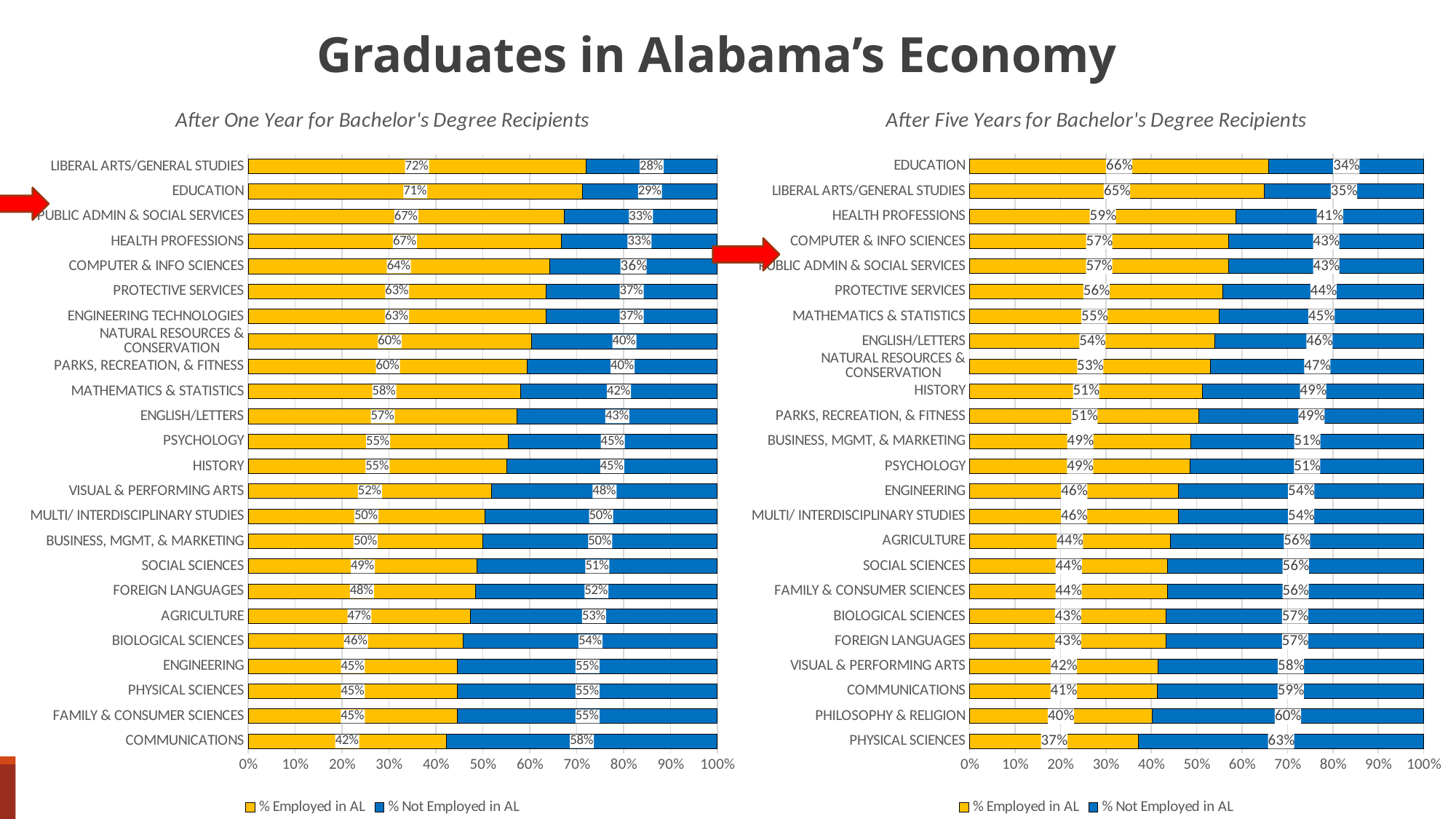
In the 'After One Year for Bachelor's Degree Recipients' chart, what is the % Employed in AL for Liberal Arts/General Studies? 72% In the 'After One Year for Bachelor's Degree Recipients' chart, what is the % Not Employed in AL for Computer & Info Sciences? 36% How many series does the legend of the 'After Five Years for Bachelor's Degree Recipients' chart list? 2 In the 'After Five Years for Bachelor's Degree Recipients' chart, which has a higher % Employed in AL: Health Professions or History? Health Professions How many categories are shown in the 'After One Year for Bachelor's Degree Recipients' chart? 24 In the 'After Five Years for Bachelor's Degree Recipients' chart, what is the % Not Employed in AL for Physical Sciences? 63% Which colour represents '% Employed in AL' in the charts' legends? Yellow In the 'After One Year for Bachelor's Degree Recipients' chart, which category has the lowest % Employed in AL? Communications In the 'After Five Years for Bachelor's Degree Recipients' chart, what is the total of the stacked bar for Psychology? 100% In the 'After Five Years for Bachelor's Degree Recipients' chart, which category has the highest % Employed in AL? Education What type of chart is the 'After One Year for Bachelor's Degree Recipients' chart? Stacked bar chart In the 'After One Year for Bachelor's Degree Recipients' chart, what is the difference between the % Employed in AL for Education and for Communications? 29%